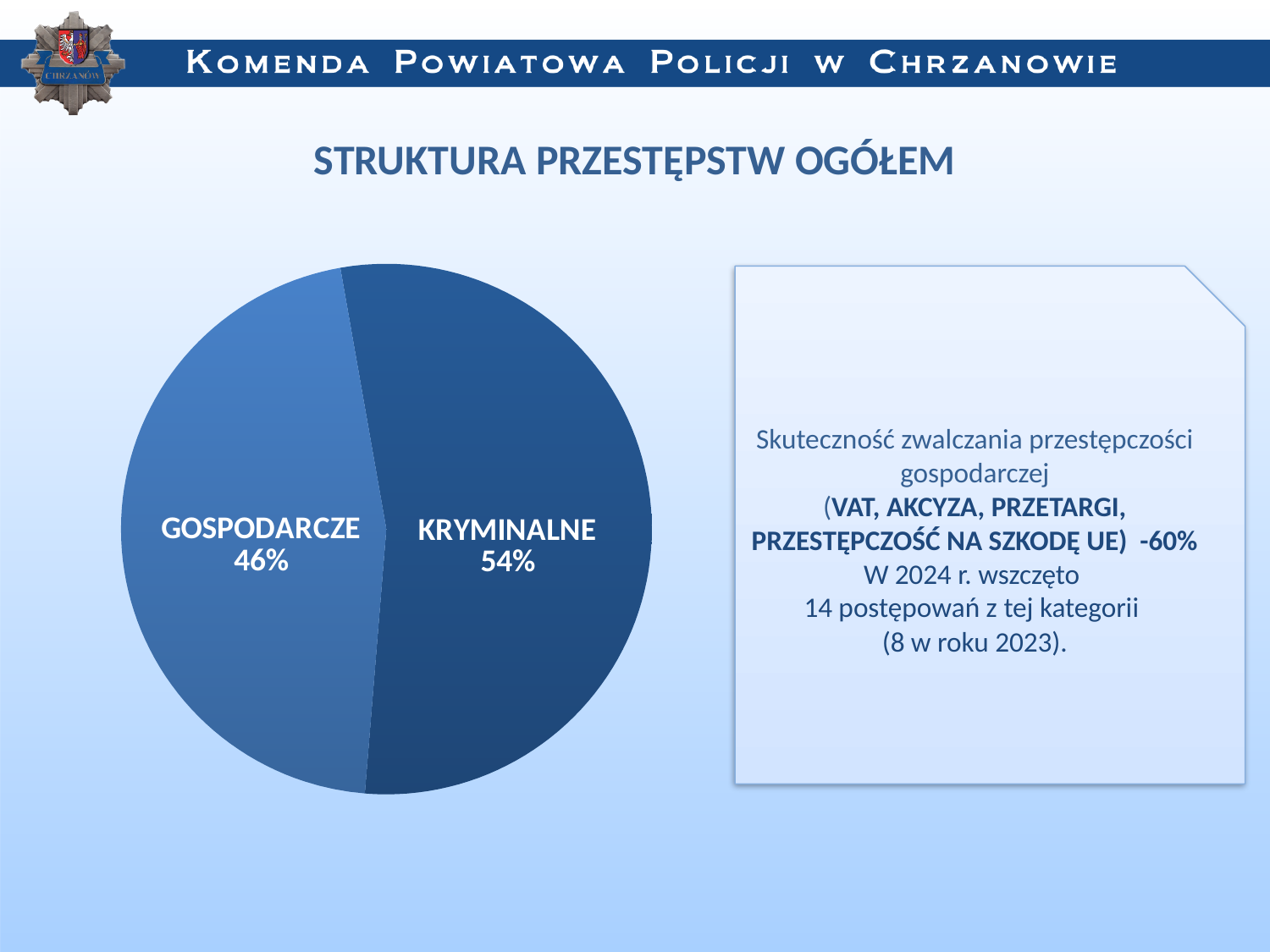
Is the share for GOSPODARCZE greater or less than 50%? less How many slices does the pie chart have? 2 Which slice of the pie chart is shown in the darker blue colour? KRYMINALNE Which is larger, the KRYMINALNE slice or the GOSPODARCZE slice? KRYMINALNE Which slice of the pie chart is the largest? KRYMINALNE Is the share for KRYMINALNE greater or less than 50%? greater What is the share for KRYMINALNE in the pie chart? 54% What type of chart is shown on the slide? pie chart What is the difference in percentage points between the KRYMINALNE and GOSPODARCZE slices? 8 What is the title of the chart on the slide? STRUKTURA PRZESTĘPSTW OGÓŁEM Which slice of the pie chart is the smallest? GOSPODARCZE What is the share for GOSPODARCZE in the pie chart? 46%